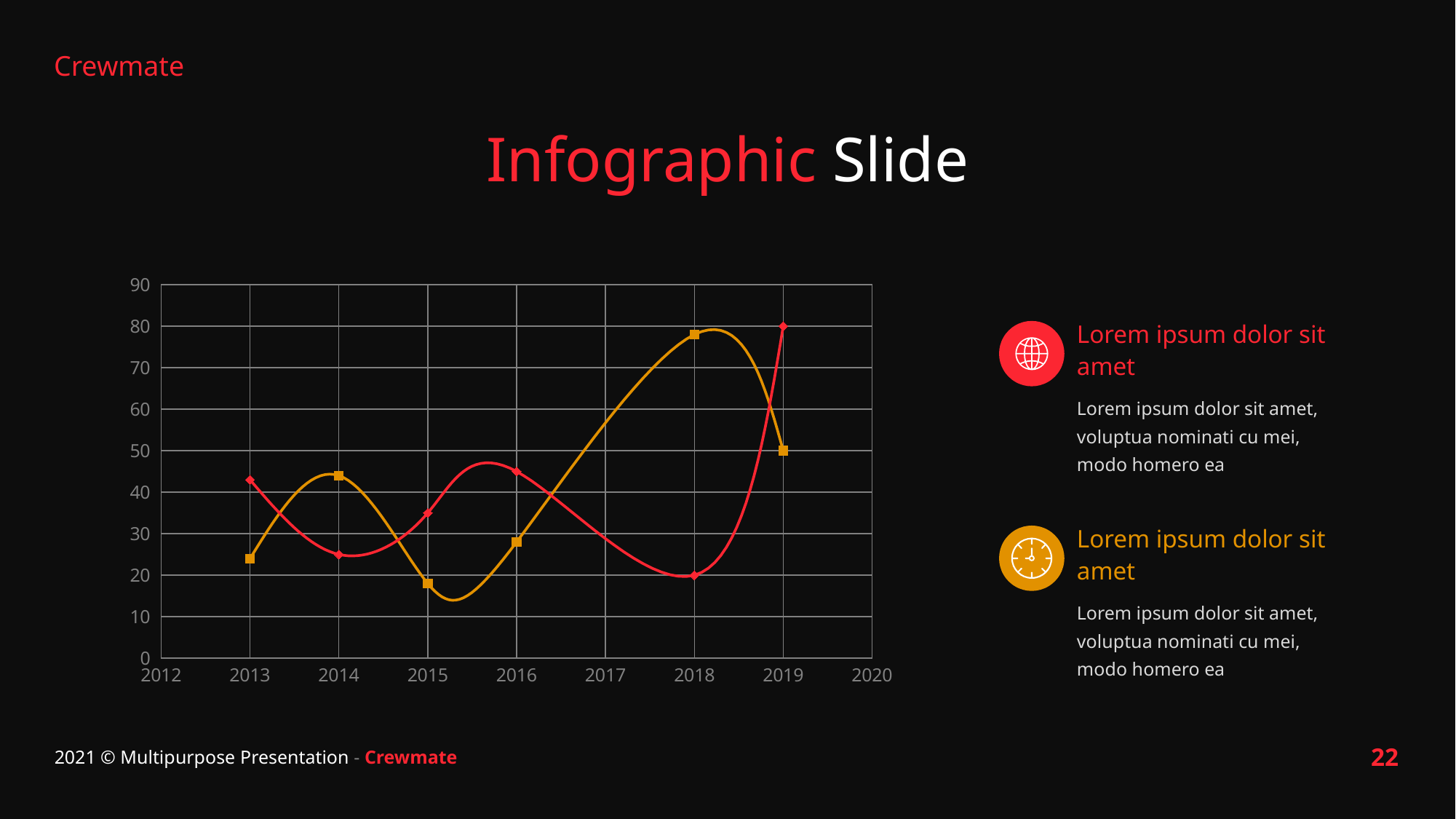
In 2016, which line has the higher value, the red line or the orange line? the red line Is the value of the orange line in 2015 greater or less than 20? less Is the value of the orange line in 2018 greater or less than 70? greater What kind of chart is shown on the slide? line chart In which year does the red line reach its lowest value? 2018 Is the value of the red line in 2014 greater or less than 30? less In which year does the orange line reach its highest value? 2018 How many lines are plotted on the chart? 2 In which year does the red line reach its highest value? 2019 How many years are labelled on the x axis of the chart? 9 In which year does the orange line reach its lowest value? 2015 In 2014, which line has the higher value, the red line or the orange line? the orange line